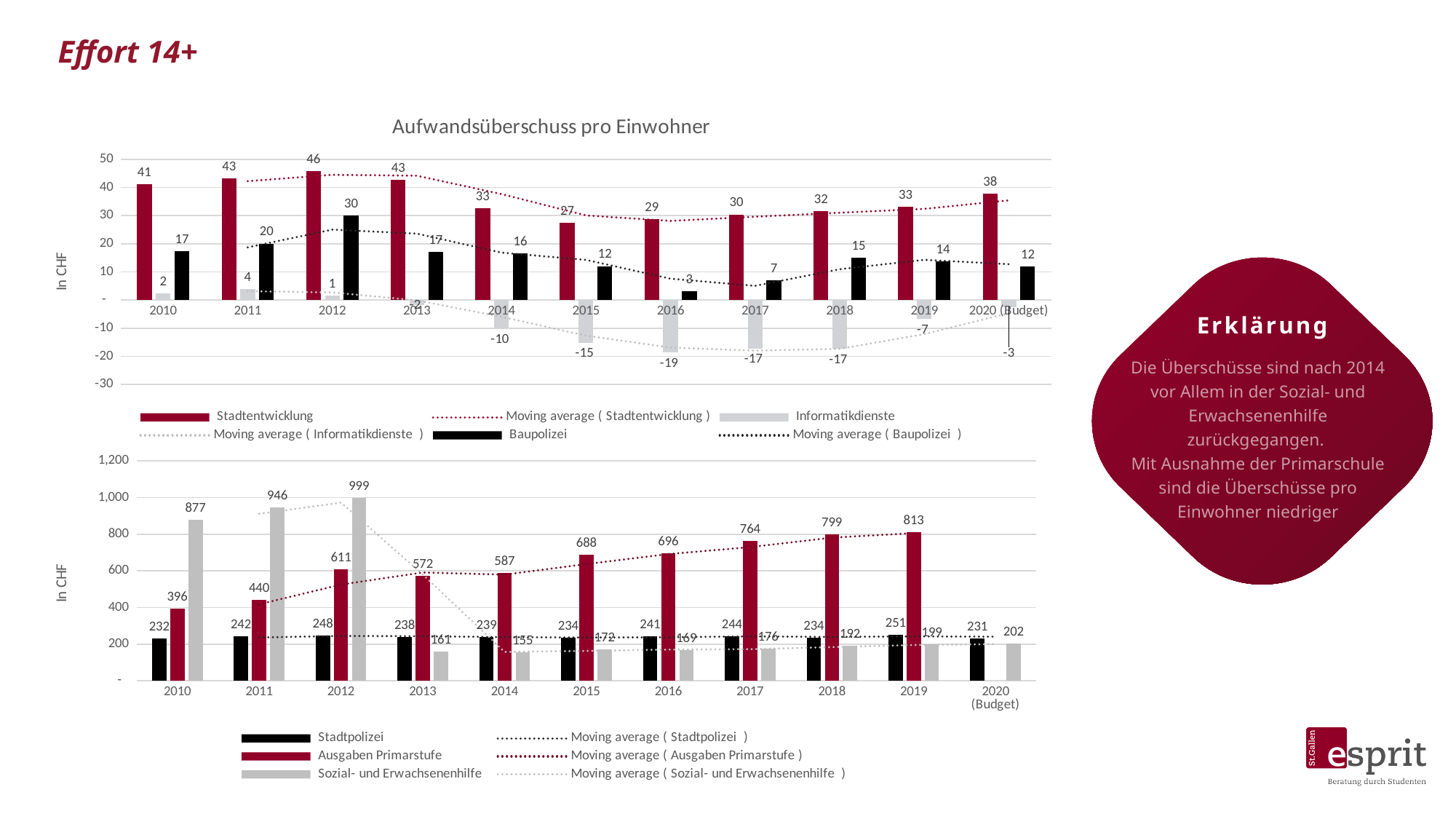
In the bottom chart, does the Ausgaben Primarstufe series generally rise or fall from 2010 to 2019? rise In the top chart 'Aufwandsüberschuss pro Einwohner', in which year is the Baupolizei value highest? 2012 In the top chart 'Aufwandsüberschuss pro Einwohner', in which year is the Stadtentwicklung value lowest? 2015 In the top chart 'Aufwandsüberschuss pro Einwohner', how many entries does the legend list? 6 In the top chart 'Aufwandsüberschuss pro Einwohner', what is the value for Informatikdienste in 2016? -19 In the bottom chart, what is the value for Ausgaben Primarstufe in 2019? 813 In the bottom chart, which is larger in 2013: Stadtpolizei or Sozial- und Erwachsenenhilfe? Stadtpolizei In the bottom chart, what is the difference between Ausgaben Primarstufe in 2018 and in 2017? 35 In the top chart 'Aufwandsüberschuss pro Einwohner', what is the difference between the Stadtentwicklung value in 2010 and in 2020 (Budget)? 3 What kind of chart is the top chart 'Aufwandsüberschuss pro Einwohner'? bar chart with moving average lines In the top chart 'Aufwandsüberschuss pro Einwohner', what is the value for Stadtentwicklung in 2012? 46 In the bottom chart, what is the value for Sozial- und Erwachsenenhilfe in 2012? 999